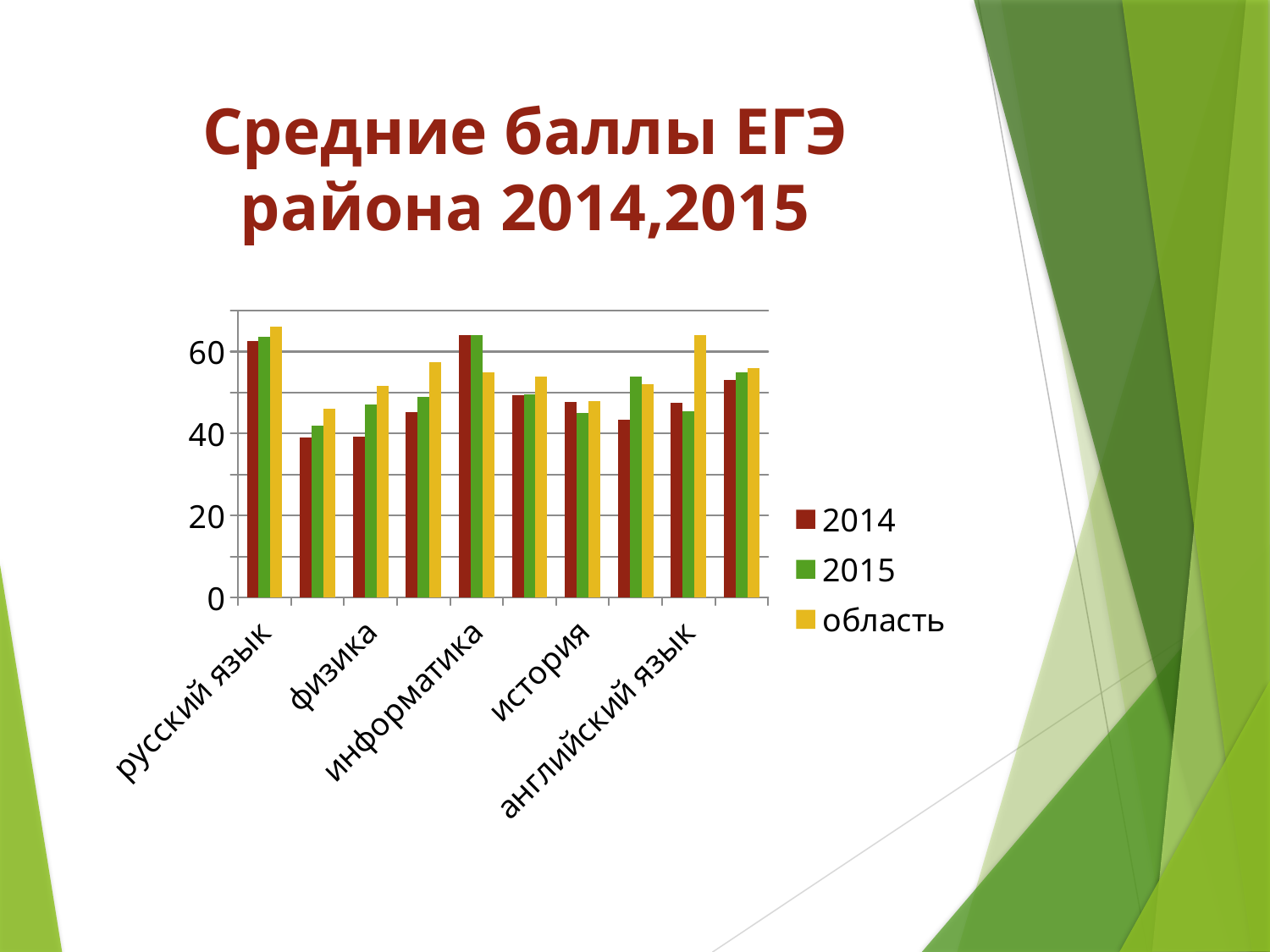
Is the область value for физика greater or less than 40? greater For английский язык, which series has the highest value? область How many series does the legend list? 3 Is the область value for английский язык greater or less than 60? greater What is the title of the chart on the slide? Средние баллы ЕГЭ района 2014,2015 For физика, which is larger: the 2014 value or the область value? область What kind of chart is shown on the slide? bar chart Is the 2014 value for русский язык greater or less than 60? greater For информатика, which is larger: the 2014 value or the область value? 2014 Which series is shown in yellow in the legend? область